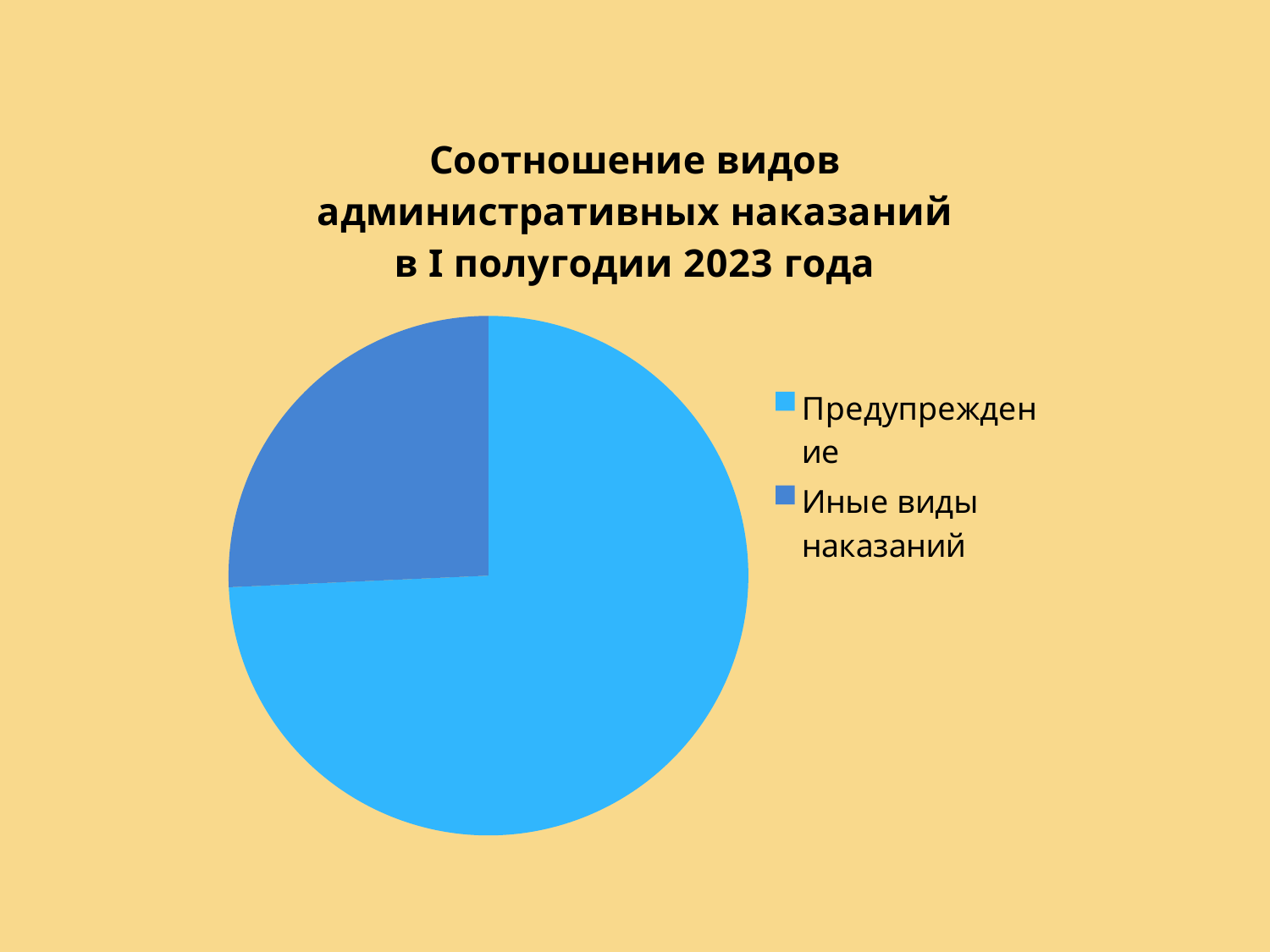
How many slices does the pie chart have? 2 What kind of chart is shown on the slide? pie chart Which category is shown in the darker blue colour in the pie chart? Иные виды наказаний How many entries does the legend of the pie chart list? 2 Which slice is larger: Предупреждение or Иные виды наказаний? Предупреждение Which category has the largest slice of the pie chart? Предупреждение What is the title of the pie chart? Соотношение видов административных наказаний в I полугодии 2023 года Which category has the smallest slice of the pie chart? Иные виды наказаний